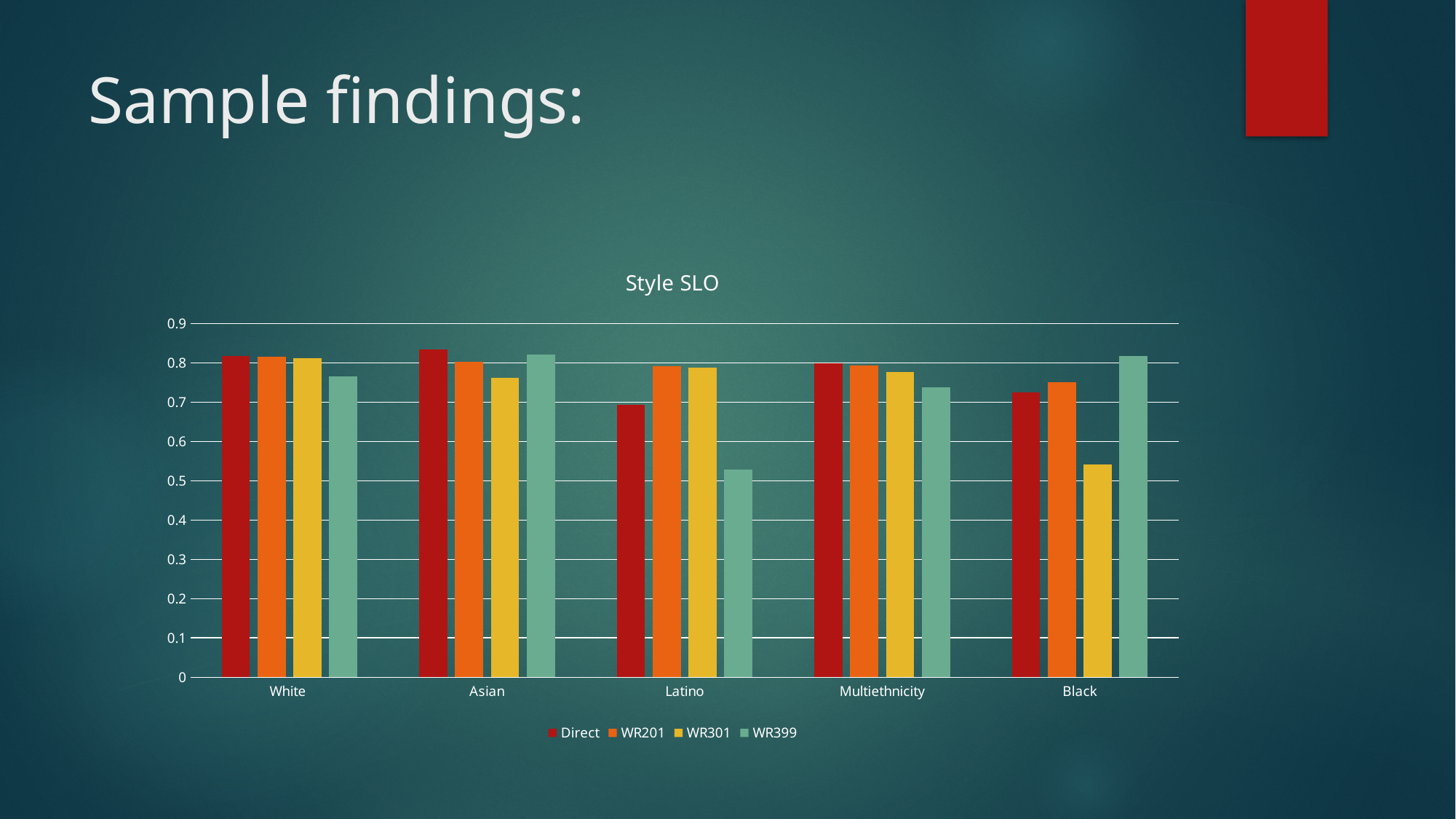
How many categories are shown on the x axis of the chart? 5 Is the Direct value for Latino greater or less than 0.8? less Which category has the lowest WR399 value? Latino For the Black category, which series has the highest value? WR399 How many series does the chart's legend list? 4 Is the WR399 value for Latino greater or less than 0.6? less Is the Direct value for Asian greater or less than 0.8? greater Which category has the lowest WR301 value? Black What kind of chart is shown on the slide? bar chart Which is larger, the WR399 value for Latino or the WR399 value for Black? Black What is the title of the chart? Style SLO